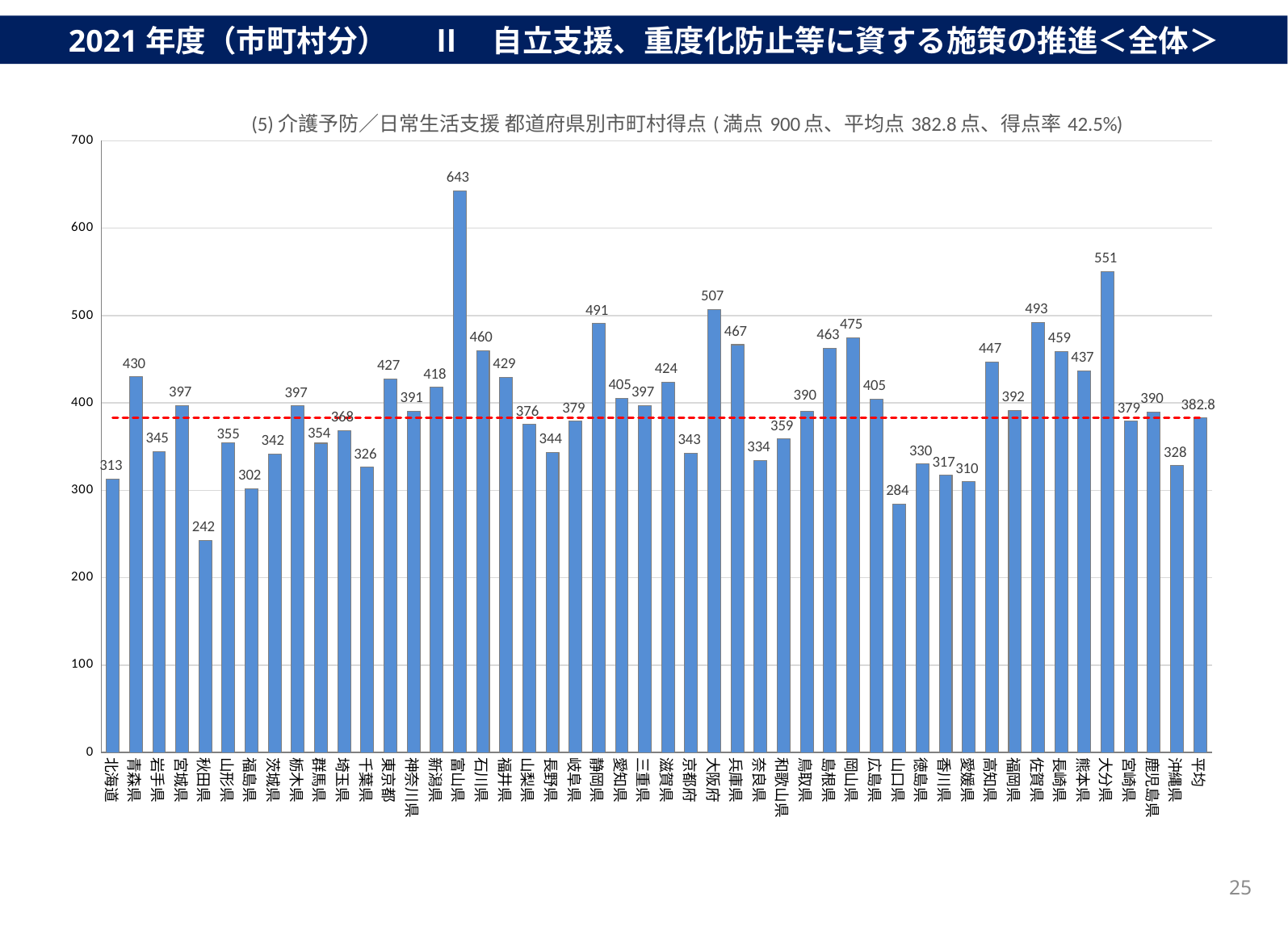
What type of chart is shown on the slide? bar chart What is the value for 秋田県? 242 What is the average score (平均点) stated in the chart title? 382.8点 What is the difference between the values for 大分県 and 大阪府? 44 What is the value for 大阪府? 507 Which prefecture has the highest score? 富山県 What is the value for 富山県? 643 Is the value for 山口県 greater or less than 300? less Which prefecture has the lowest score? 秋田県 What is the difference between the values for 富山県 and 秋田県? 401 What is the value shown for 平均? 382.8 Which is larger, the value for 佐賀県 or the value for 高知県? 佐賀県